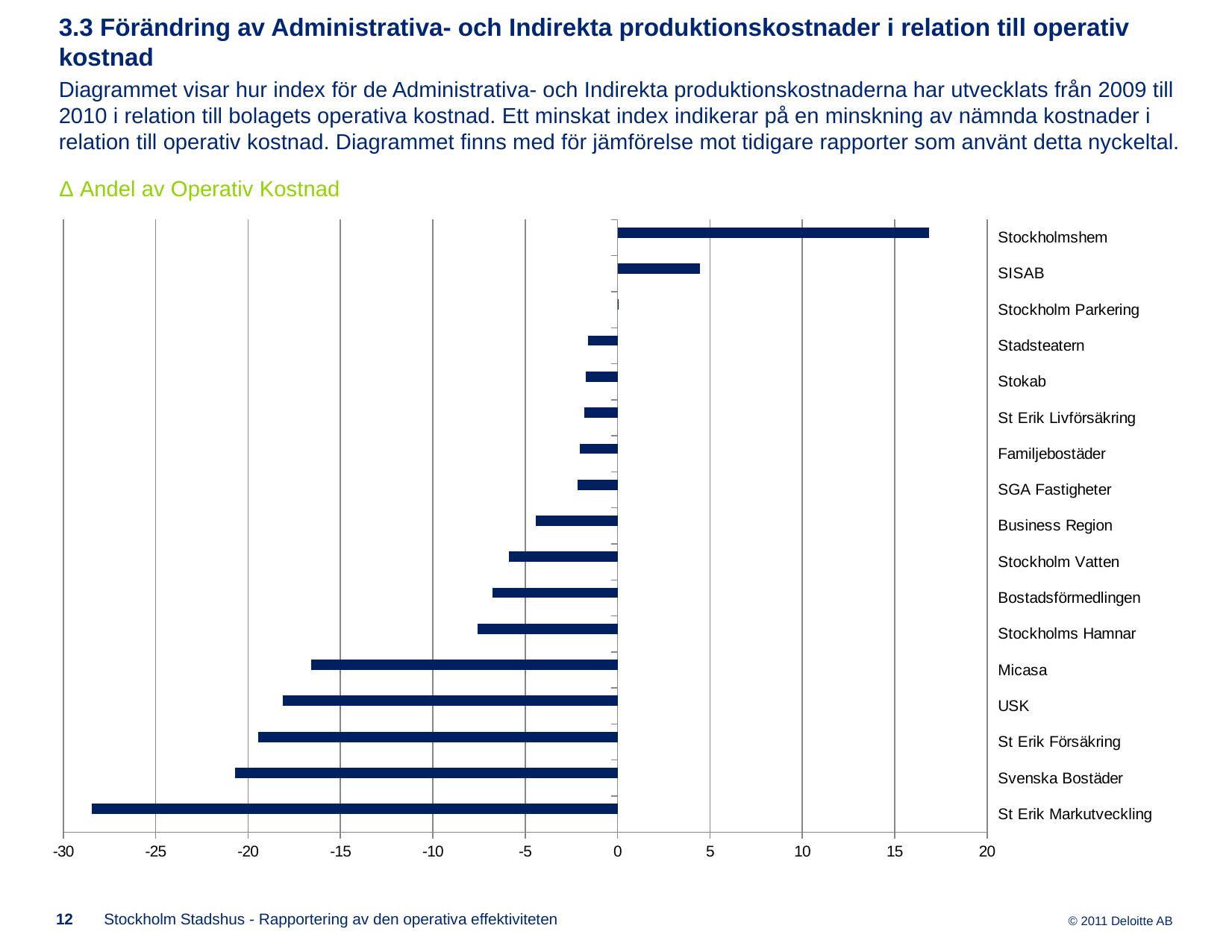
What kind of chart is shown on the slide? bar chart Which has the larger value, Svenska Bostäder or USK? USK What is the title shown above the chart? Δ Andel av Operativ Kostnad Is the value for Stockholmshem greater or less than 15? greater Which has the larger value, Stockholm Vatten or Business Region? Business Region How many companies (categories) are plotted in the chart? 17 Which company has the lowest value in the chart? St Erik Markutveckling Is the value for Micasa greater or less than -15? less Is the value for St Erik Markutveckling greater or less than -25? less Which company has the highest value in the chart? Stockholmshem